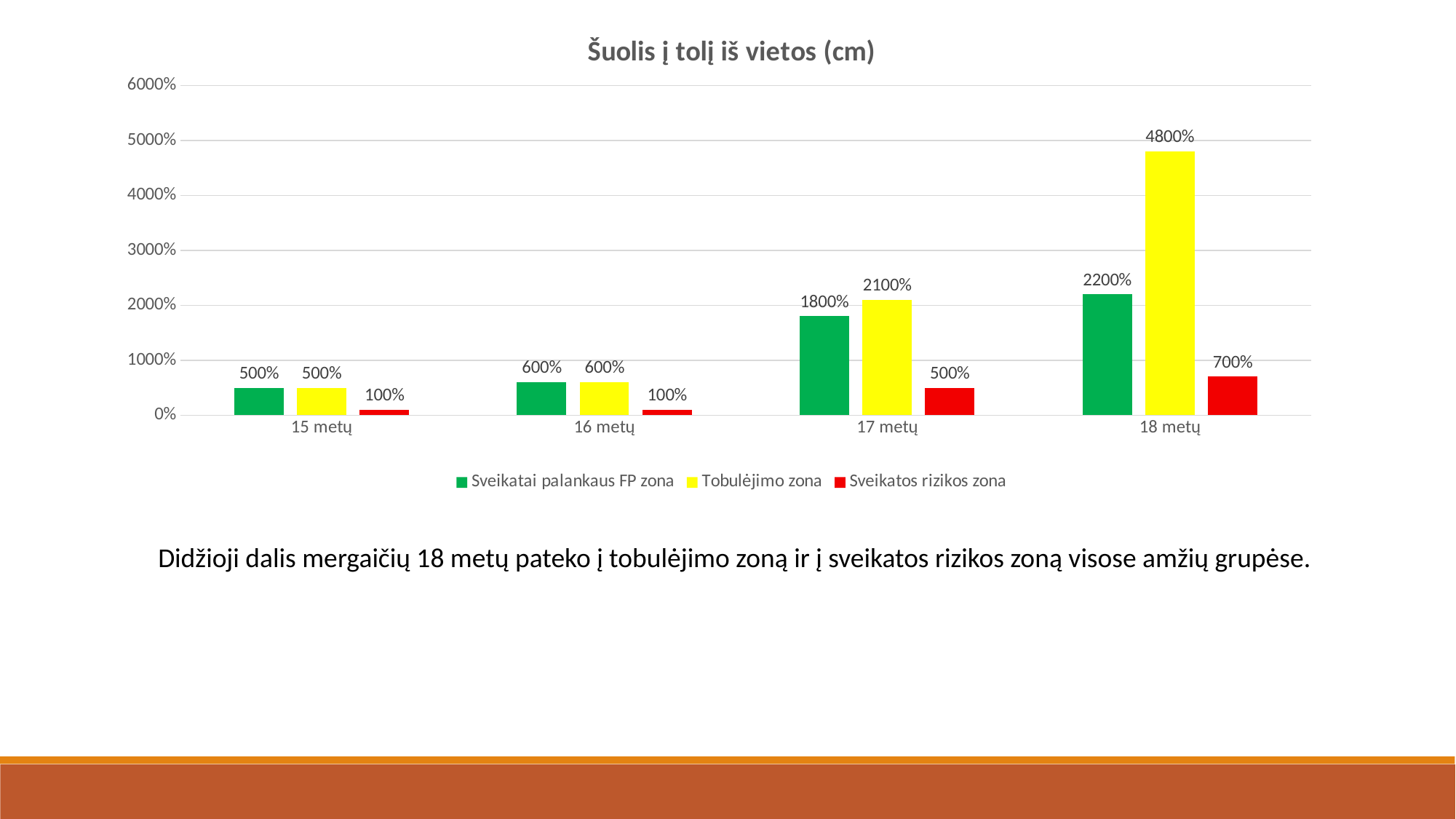
What is the value for Sveikatos rizikos zona at 16 metų? 100% What is the value for Sveikatai palankaus FP zona at 17 metų? 1800% Which is larger at 17 metų: Tobulėjimo zona or Sveikatos rizikos zona? Tobulėjimo zona Is the value for Sveikatai palankaus FP zona at 18 metų greater or less than 2000%? greater Which age group has the highest value for Tobulėjimo zona? 18 metų What is the value for Tobulėjimo zona at 18 metų? 4800% How many age groups are shown on the x axis? 4 What is the title of the chart? Šuolis į tolį iš vietos (cm) Which age group has the lowest value for Sveikatai palankaus FP zona? 15 metų What kind of chart is shown on the slide? bar chart How many series does the legend list? 3 What is the difference between the Tobulėjimo zona and Sveikatai palankaus FP zona values at 18 metų? 2600%